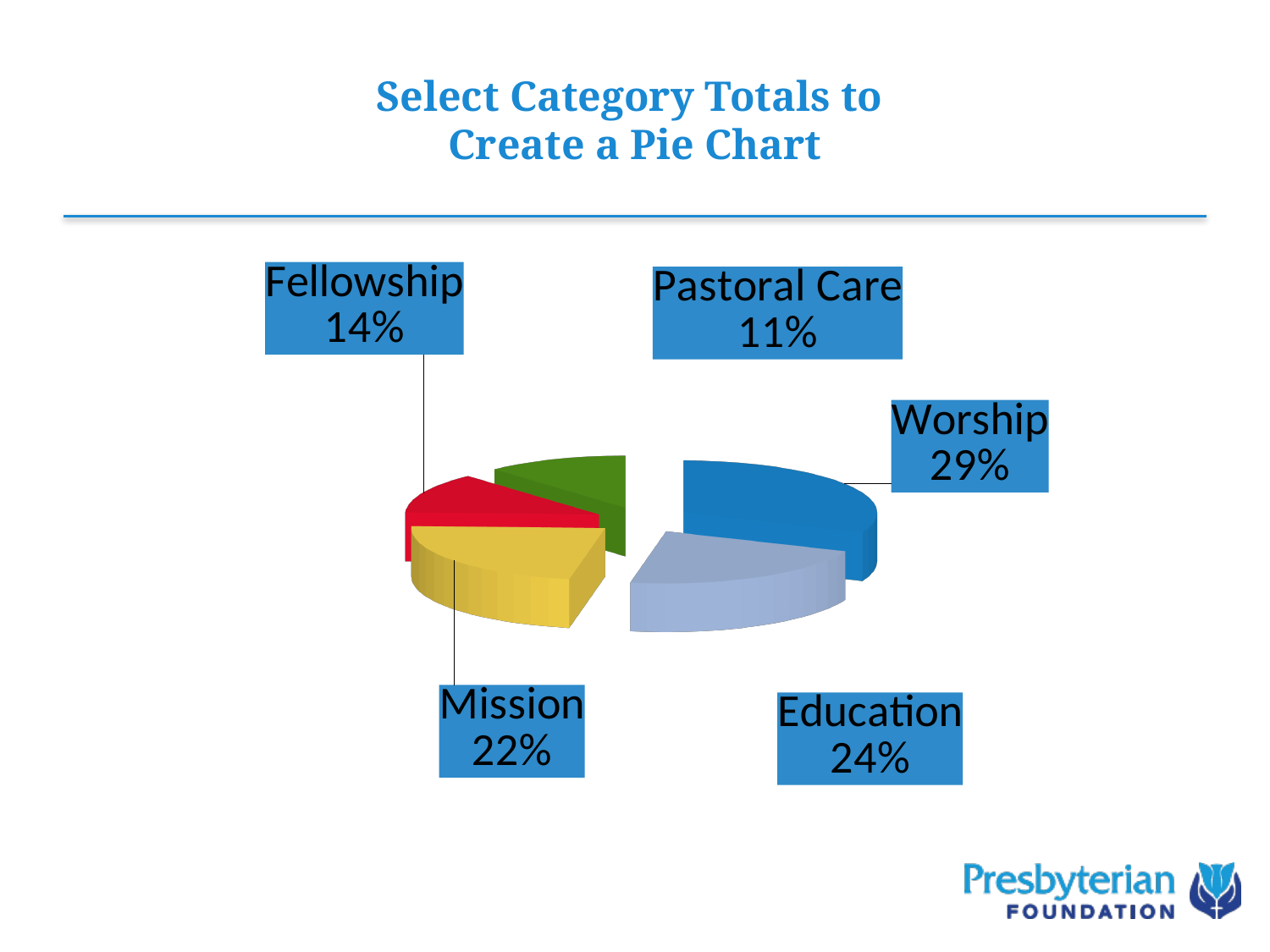
How many categories are shown in the pie chart? 5 Which is larger, the share for Education or the share for Mission? Education What share of the pie does Education represent? 24% What share of the pie does Fellowship represent? 14% What share of the pie does Pastoral Care represent? 11% Which category has the smallest share of the pie? Pastoral Care What share of the pie does Mission represent? 22% What share of the pie does Worship represent? 29% What kind of chart is shown on the slide? Pie chart What is the difference in percentage points between Worship and Pastoral Care? 18 What is the title of the slide containing the chart? Select Category Totals to Create a Pie Chart Which category has the largest share of the pie? Worship